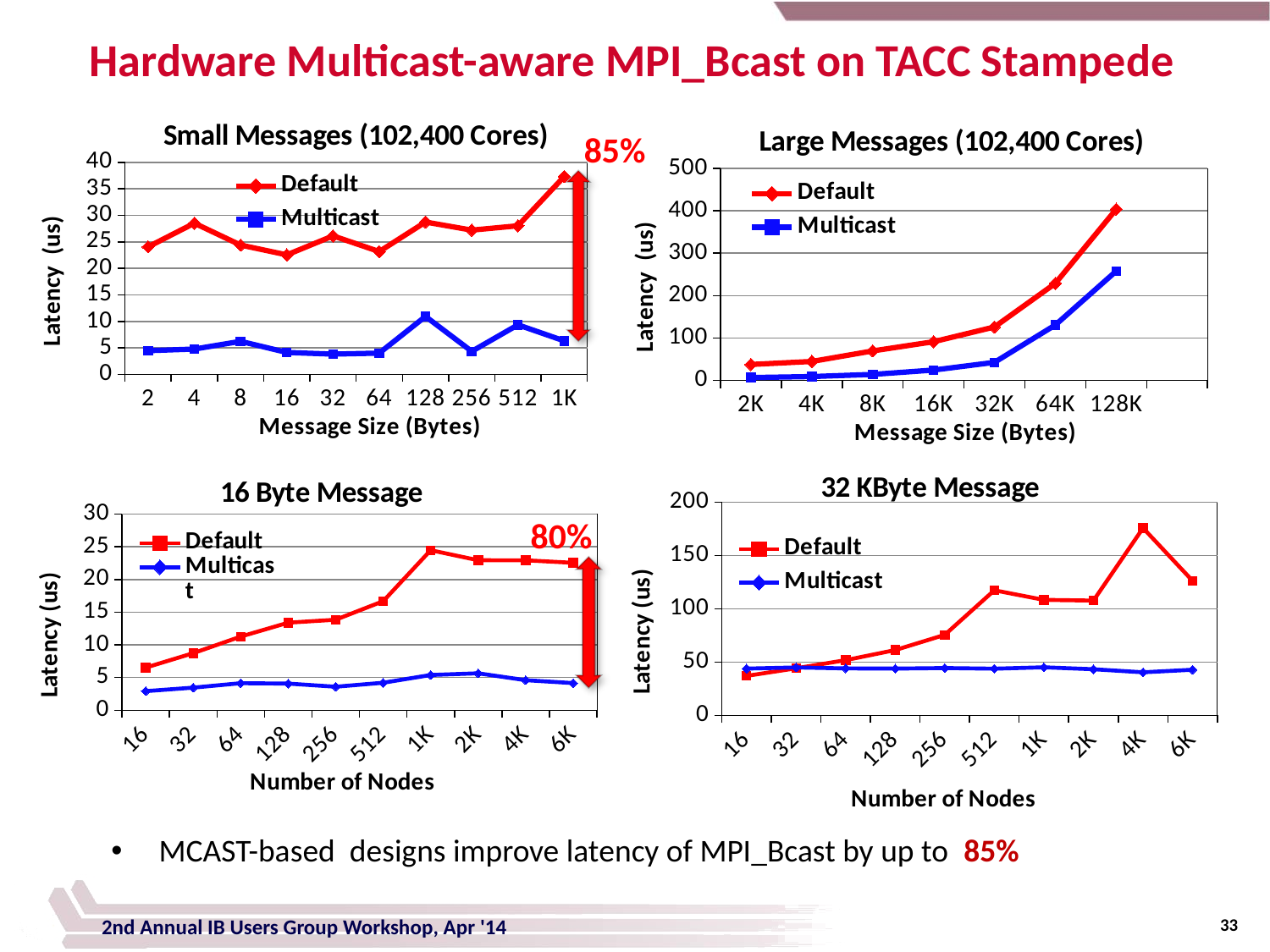
How many series does the legend of the 'Small Messages (102,400 Cores)' chart list? 2 How many message sizes are plotted on the x axis of the 'Large Messages (102,400 Cores)' chart? 7 In the 'Small Messages (102,400 Cores)' chart, is the Default latency at 1K bytes greater or less than 30? greater In the 'Large Messages (102,400 Cores)' chart, which series has the higher latency at 64K bytes, Default or Multicast? Default In the '16 Byte Message' chart, how many node counts are plotted on the x axis? 10 In the '32 KByte Message' chart, is the Multicast latency at 6K nodes greater or less than 100? less How many message sizes are plotted on the x axis of the 'Small Messages (102,400 Cores)' chart? 10 What percentage improvement is annotated with the red arrow on the '16 Byte Message' chart? 80% What kind of chart is the 'Small Messages (102,400 Cores)' chart? line chart In the 'Large Messages (102,400 Cores)' chart, does the Multicast latency rise or fall as message size increases? rises In the 'Large Messages (102,400 Cores)' chart, is the Default latency at 128K bytes greater or less than 300? greater In the '32 KByte Message' chart, at which number of nodes is the Default latency highest? 4K